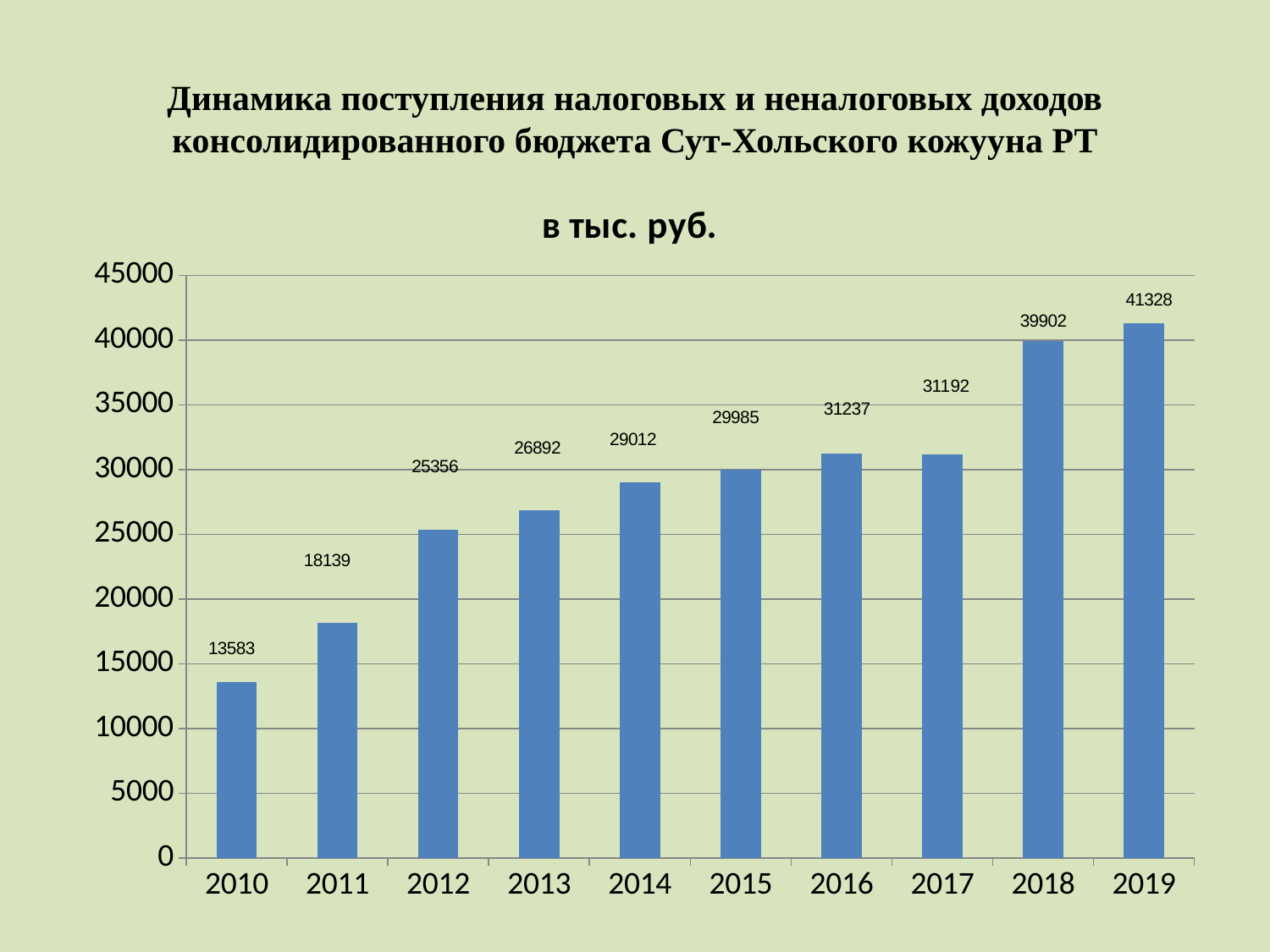
Which year has the highest value? 2019 Which is larger, the value for 2012 or the value for 2014? 2014 What is the difference between the values for 2019 and 2010? 27745 What is the difference between the values for 2018 and 2017? 8710 Do the values generally rise or fall from 2010 to 2019? rise What type of chart is shown on the slide? bar chart What is the value for 2010? 13583 Is the value for 2013 greater or less than 25000? greater How many years are shown on the x axis? 10 What is the value for 2018? 39902 What is the value for 2015? 29985 Which year has the lowest value? 2010